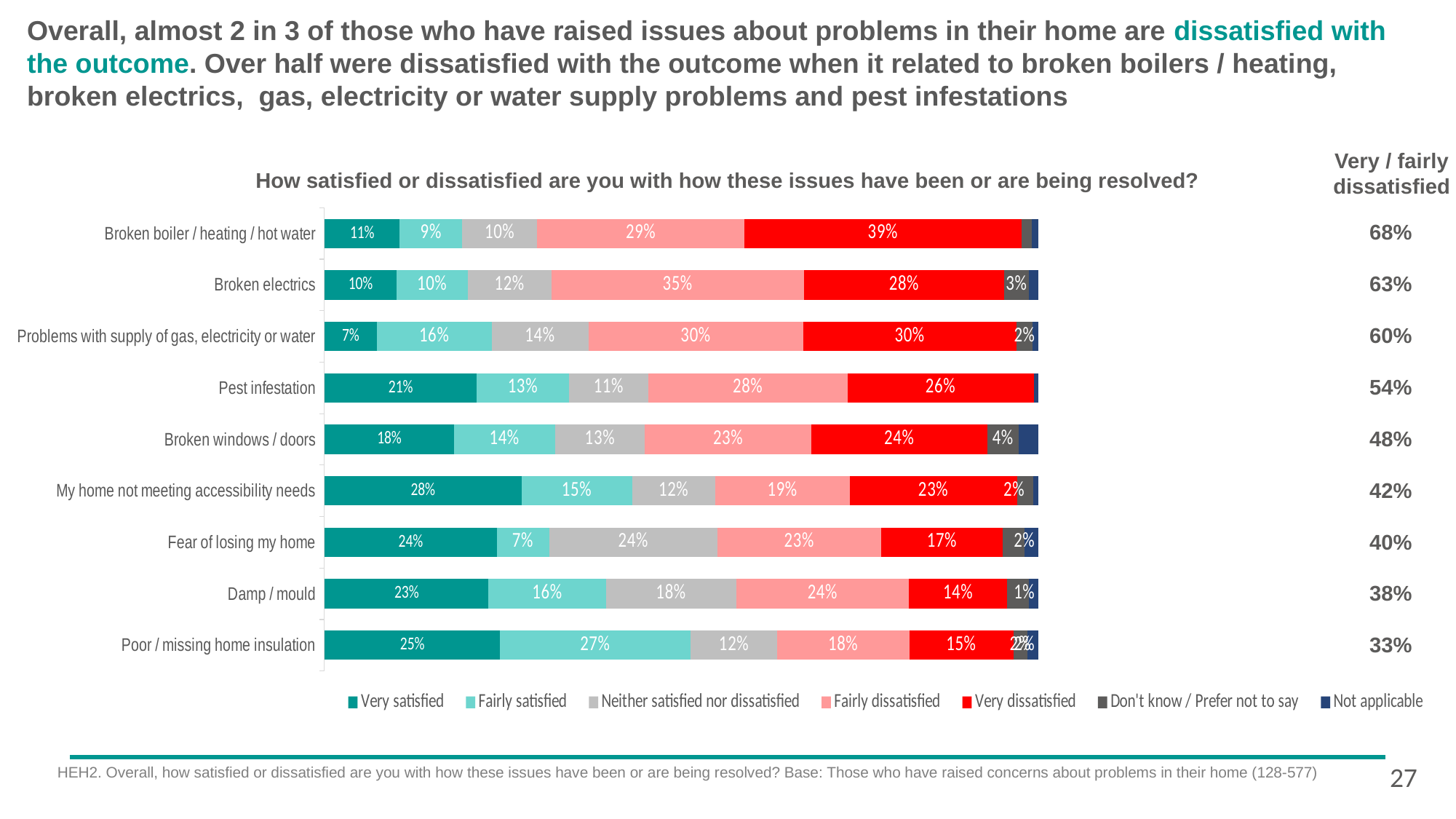
What percentage of respondents with damp / mould issues were very satisfied? 23% Which issue has the lowest 'Very satisfied' percentage? Problems with supply of gas, electricity or water Which issue has the highest 'Very satisfied' percentage? My home not meeting accessibility needs What is the difference in the 'Very dissatisfied' percentage between broken boiler / heating / hot water and damp / mould? 25 percentage points How many issue categories are shown in the chart? 9 How many series does the legend list? 7 What percentage of respondents with a broken boiler / heating / hot water issue were very dissatisfied? 39% What percentage of respondents with broken electrics were fairly dissatisfied? 35% What is the 'Very / fairly dissatisfied' percentage shown for poor / missing home insulation? 33% Which issue has the highest 'Very dissatisfied' percentage? Broken boiler / heating / hot water What type of chart is shown on the slide? Stacked bar chart Which has a larger 'Fairly dissatisfied' percentage: broken electrics or pest infestation? Broken electrics